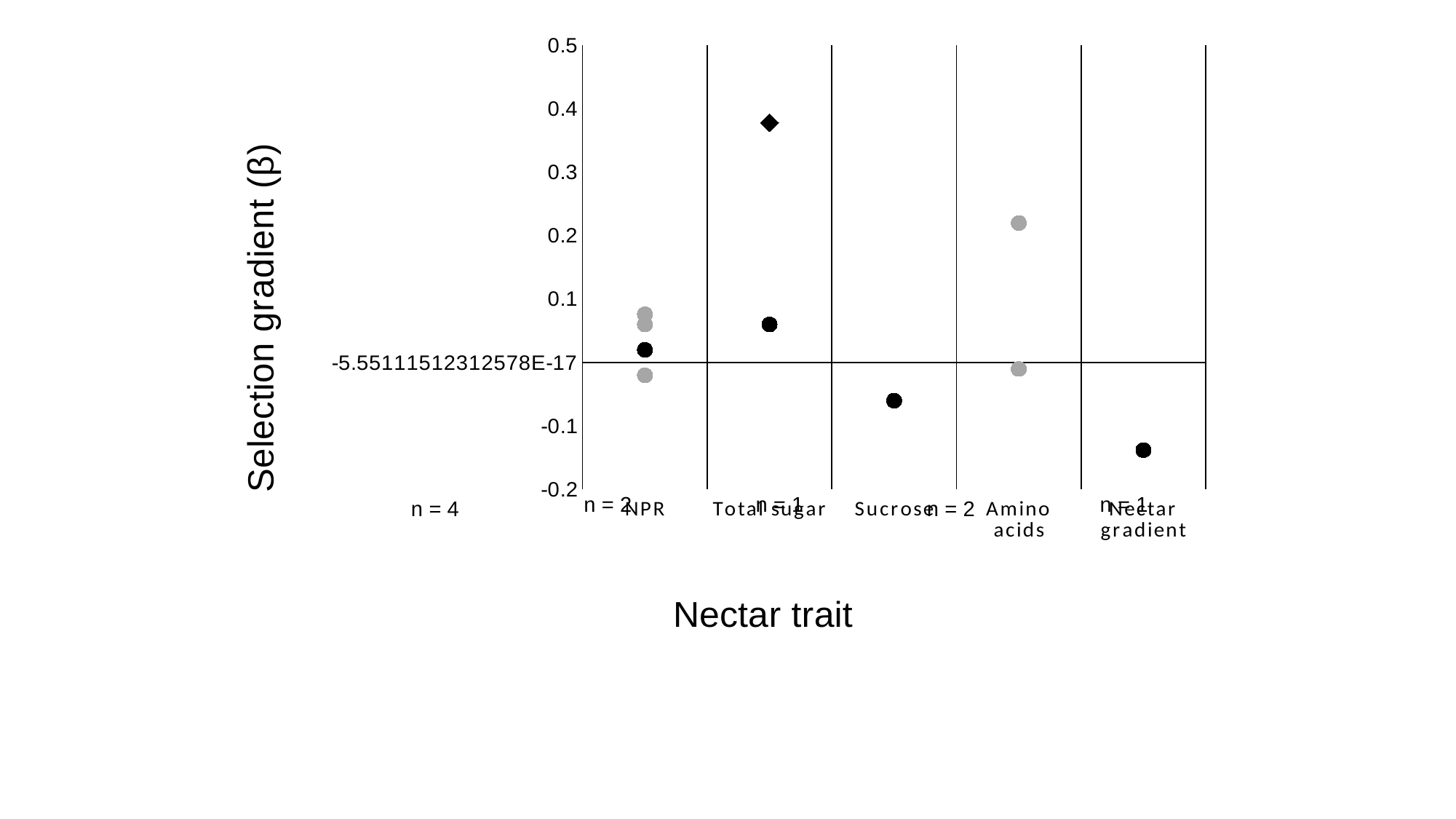
What kind of chart is shown on the slide? scatter plot Which nectar trait has the highest plotted selection gradient? Total sugar Which is larger, the highest value for Amino acids or the highest value for NPR? Amino acids Is the value for Nectar gradient greater or less than -0.1? less What is the title of the x axis? Nectar trait How many nectar trait categories are shown along the x axis? 5 Which nectar trait has the lowest plotted selection gradient? Nectar gradient What is the title of the y axis? Selection gradient (β) Which is larger, the value for Sucrose or the value for Nectar gradient? Sucrose Is the highest value for Total sugar greater or less than 0.3? greater Is the value for Sucrose greater or less than 0? less